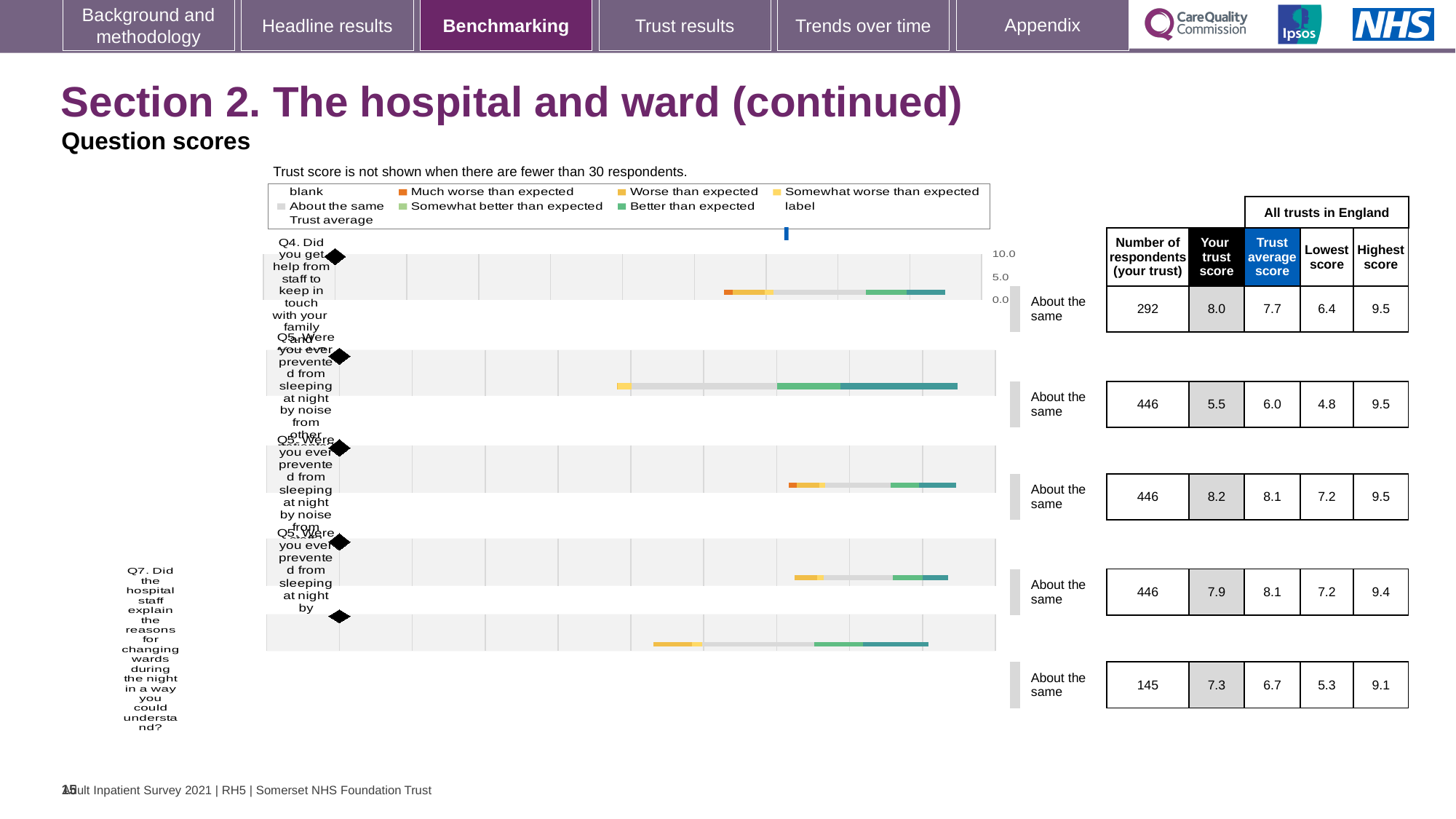
What is the trust average score for Q5 (prevented from sleeping at night by noise from other patients)? 6.0 What is the difference between the trust score and the trust average score for Q4? 0.3 What benchmark category is shown for Q4? About the same What kind of chart is used to show the question scores on this slide? bar chart What is the 'Your trust score' for Q4 (help from staff to keep in touch with family and friends)? 8.0 How many questions (bars) are plotted in the question scores chart? 5 What is the highest score across all trusts in England for Q7? 9.1 For Q7, which is larger: the trust score or the trust average score? the trust score (7.3) Which question has the lowest 'Your trust score' in the table? Q5 (noise from other patients), 5.5 Which colour in the legend represents 'Much worse than expected'? orange How many respondents answered Q7 (explaining reasons for changing wards during the night)? 145